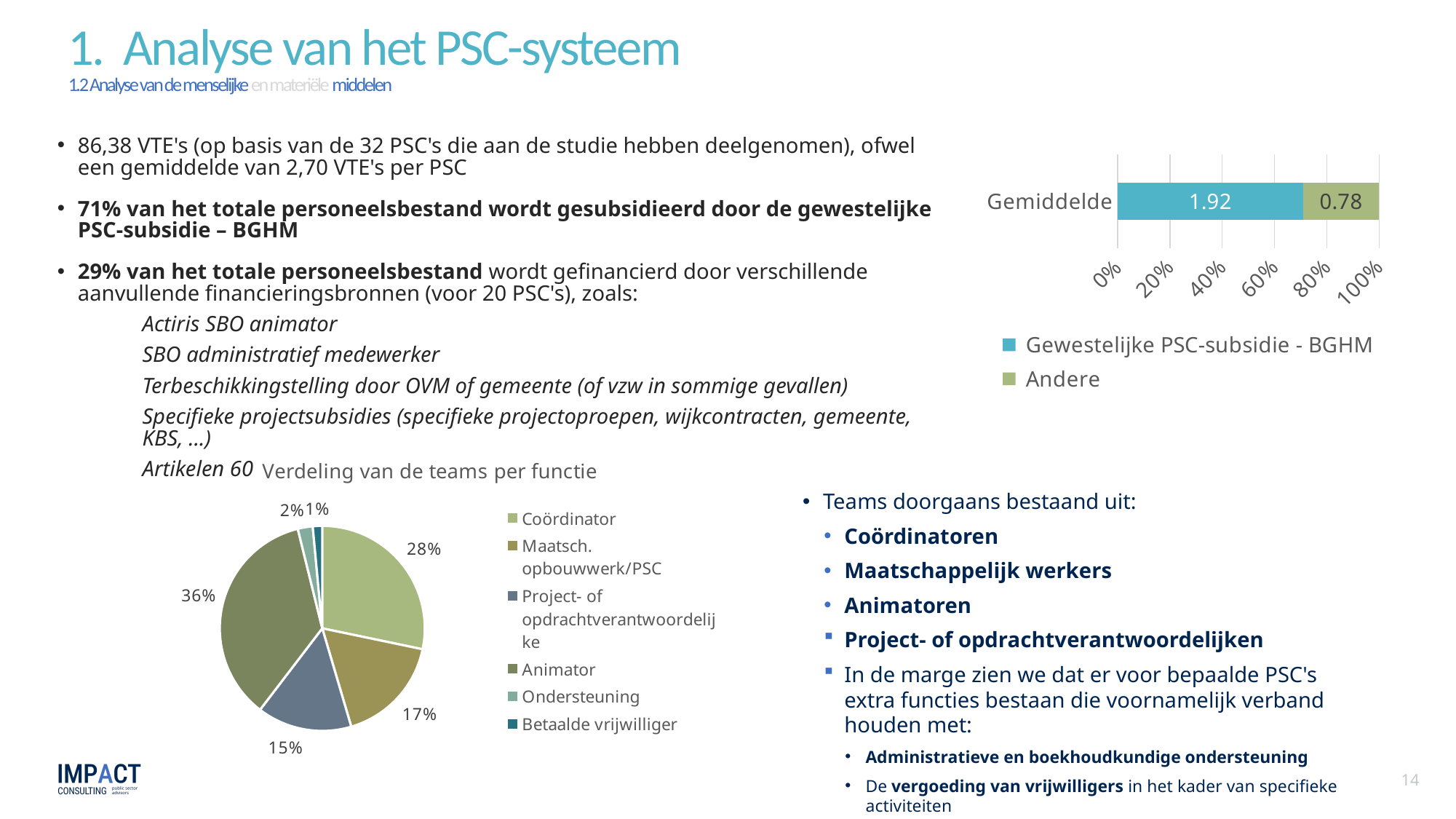
In the stacked bar chart at the top right, what is the value for Andere? 0.78 In the pie chart 'Verdeling van de teams per functie', which function has the smallest share? Betaalde vrijwilliger In the stacked bar chart at the top right, which series has the larger value, Gewestelijke PSC-subsidie - BGHM or Andere? Gewestelijke PSC-subsidie - BGHM In the pie chart 'Verdeling van de teams per functie', which function has the largest share? Animator In the stacked bar chart at the top right, what is the total of the Gemiddelde bar? 2.70 In the stacked bar chart at the top right, how many series does the legend list? 2 How many slices does the pie chart 'Verdeling van de teams per functie' have? 6 In the pie chart 'Verdeling van de teams per functie', what share does Coördinator have? 28% What kind of chart is shown at the top right of the slide? Stacked bar chart In the stacked bar chart at the top right, what is the value for Gewestelijke PSC-subsidie - BGHM? 1.92 In the pie chart 'Verdeling van de teams per functie', what is the difference between the shares of Animator and Maatsch. opbouwwerk/PSC? 19% In the pie chart 'Verdeling van de teams per functie', what share does Animator have? 36%